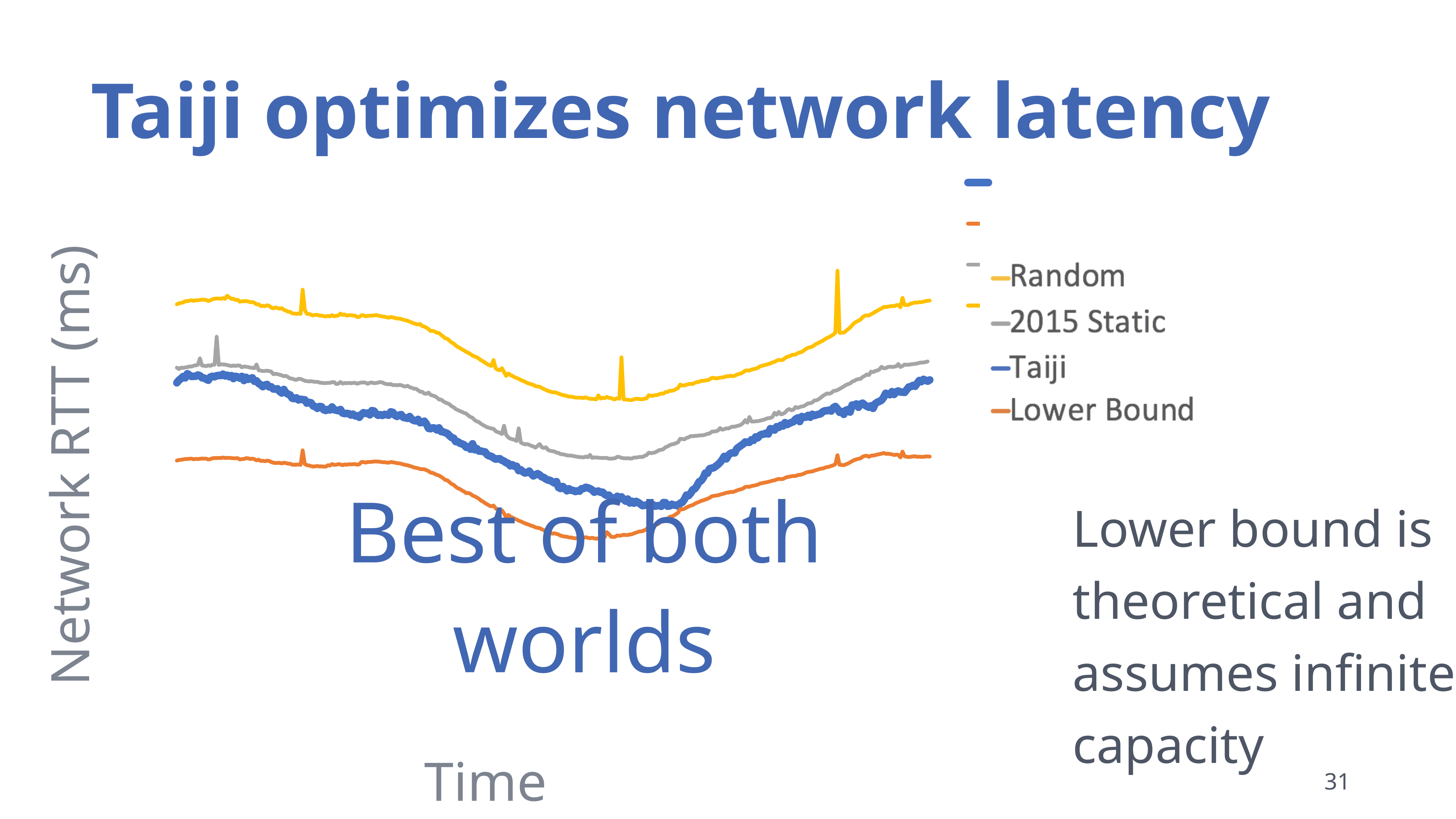
Which series has a higher network RTT, Taiji or Lower Bound? Taiji What kind of chart is shown on the slide? line chart What colour is the Taiji line in the chart? blue Which series has a higher network RTT, Random or 2015 Static? Random What is the label of the vertical axis? Network RTT (ms) Which series has a higher network RTT, Taiji or 2015 Static? 2015 Static How does the Taiji line change over time from left to right? falls then rises Which series has the lowest network RTT across the chart? Lower Bound How many series does the chart's legend list? 4 Which series has the highest network RTT across the chart? Random